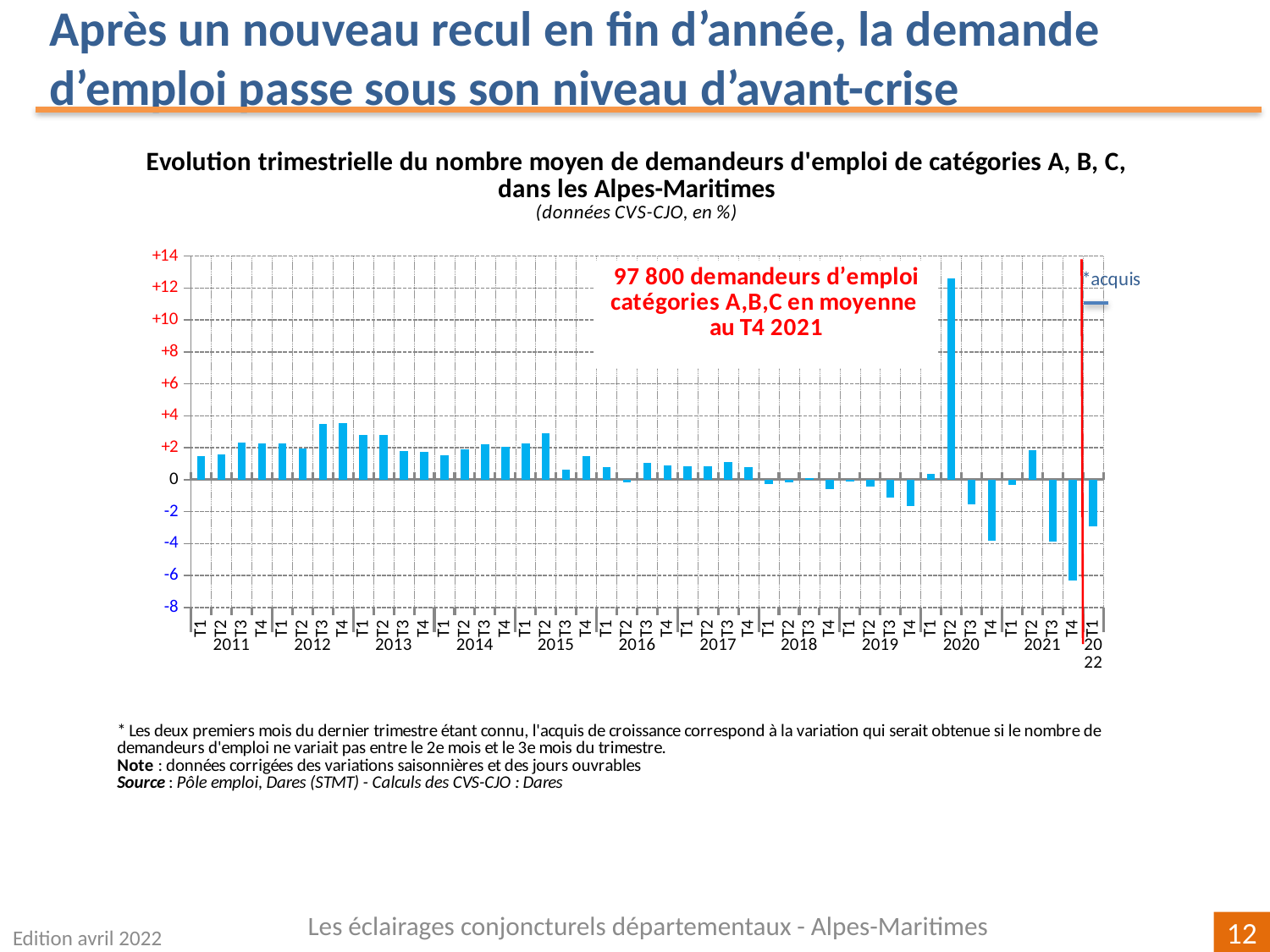
What kind of chart is shown on the slide? bar chart Is the value for T3 2012 greater or less than +2? greater Is the value for T4 2019 greater or less than 0? less Is the value for T1 2022 greater or less than -2? less How many quarterly bars are plotted in the chart? 45 According to the red annotation on the chart, how many demandeurs d'emploi of categories A, B, C were there on average in T4 2021? 97 800 Which is larger, the value for T2 2020 or the value for T3 2012? T2 2020 Which quarter shows the lowest value in the chart? T4 2021 Which quarter shows the highest value in the chart? T2 2020 In what unit are the data in the chart expressed, according to the subtitle? %